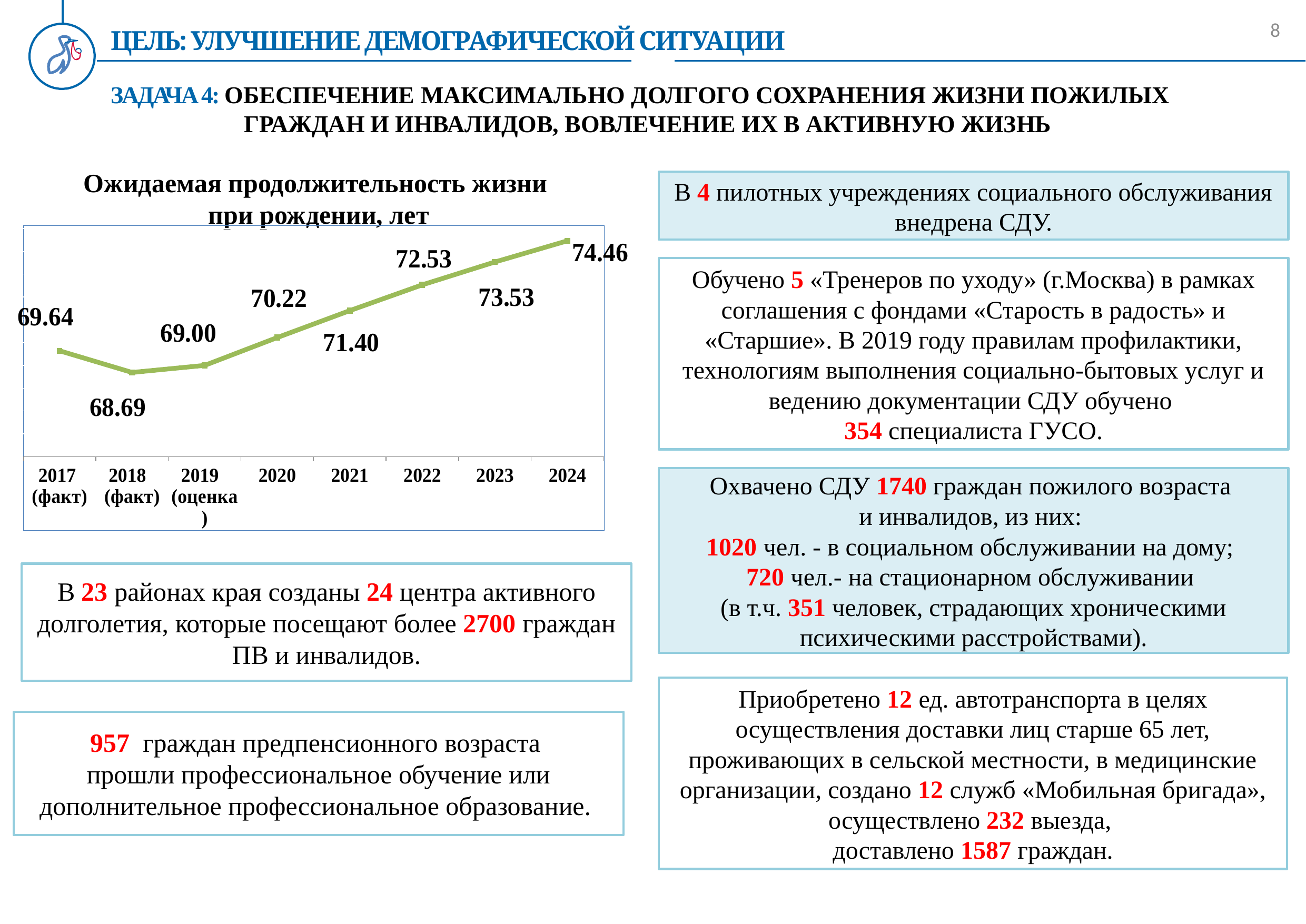
Do the values rise or fall from 2019 (оценка) to 2024? rise Which year has the lowest life expectancy value in the chart? 2018 (факт) What is the expected life expectancy at birth for 2017 (факт)? 69.64 How many years (data points) are plotted in the life expectancy chart? 8 What is the value for 2021? 71.40 Which is larger, the value for 2017 (факт) or the value for 2018 (факт)? 2017 (факт) What type of chart is used to show expected life expectancy at birth? line chart What is the difference between the 2023 value and the 2022 value? 1.00 Which year has the highest life expectancy value in the chart? 2024 What is the value for 2019 (оценка)? 69.00 What is the difference between the 2024 value and the 2017 (факт) value? 4.82 What value is shown for 2024 in the life expectancy chart? 74.46